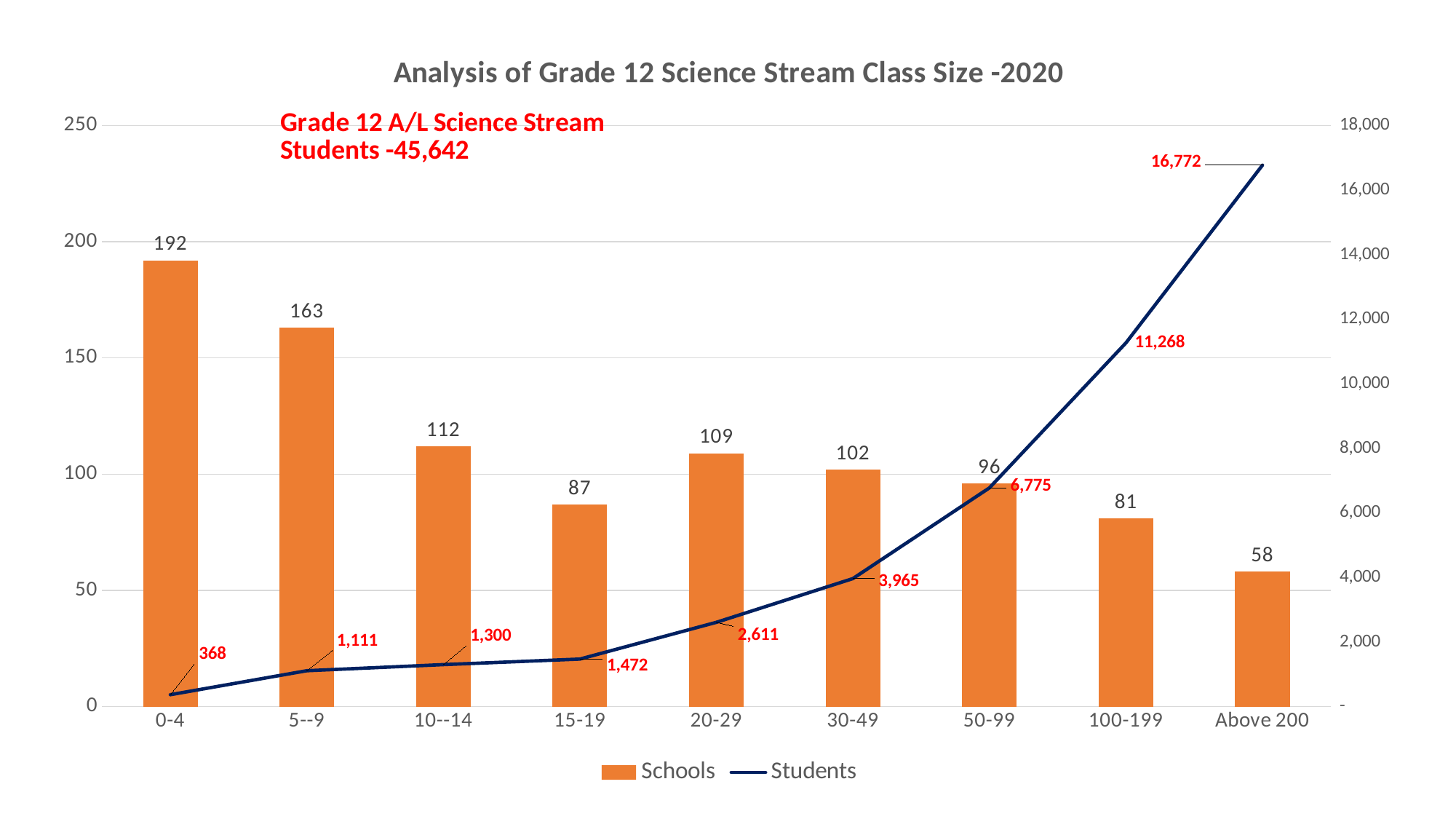
What is the overall trend of the Students line from left to right along the x axis? rising Which class size category has the highest number of Schools? 0-4 Which has more Schools, the 20-29 category or the 30-49 category? 20-29 How many series does the legend list? 2 What is the difference in the number of Students between the 100-199 and 50-99 categories? 4,493 What is the difference in the number of Schools between the 5--9 and 10--14 categories? 51 Which class size category has the lowest number of Students? 0-4 What is the number of Students for the Above 200 class size category? 16,772 What is the number of Students for the 30-49 class size category? 3,965 How many class size categories are shown on the x axis? 9 What is the number of Schools for the 0-4 class size category? 192 What is the title of the chart? Analysis of Grade 12 Science Stream Class Size -2020